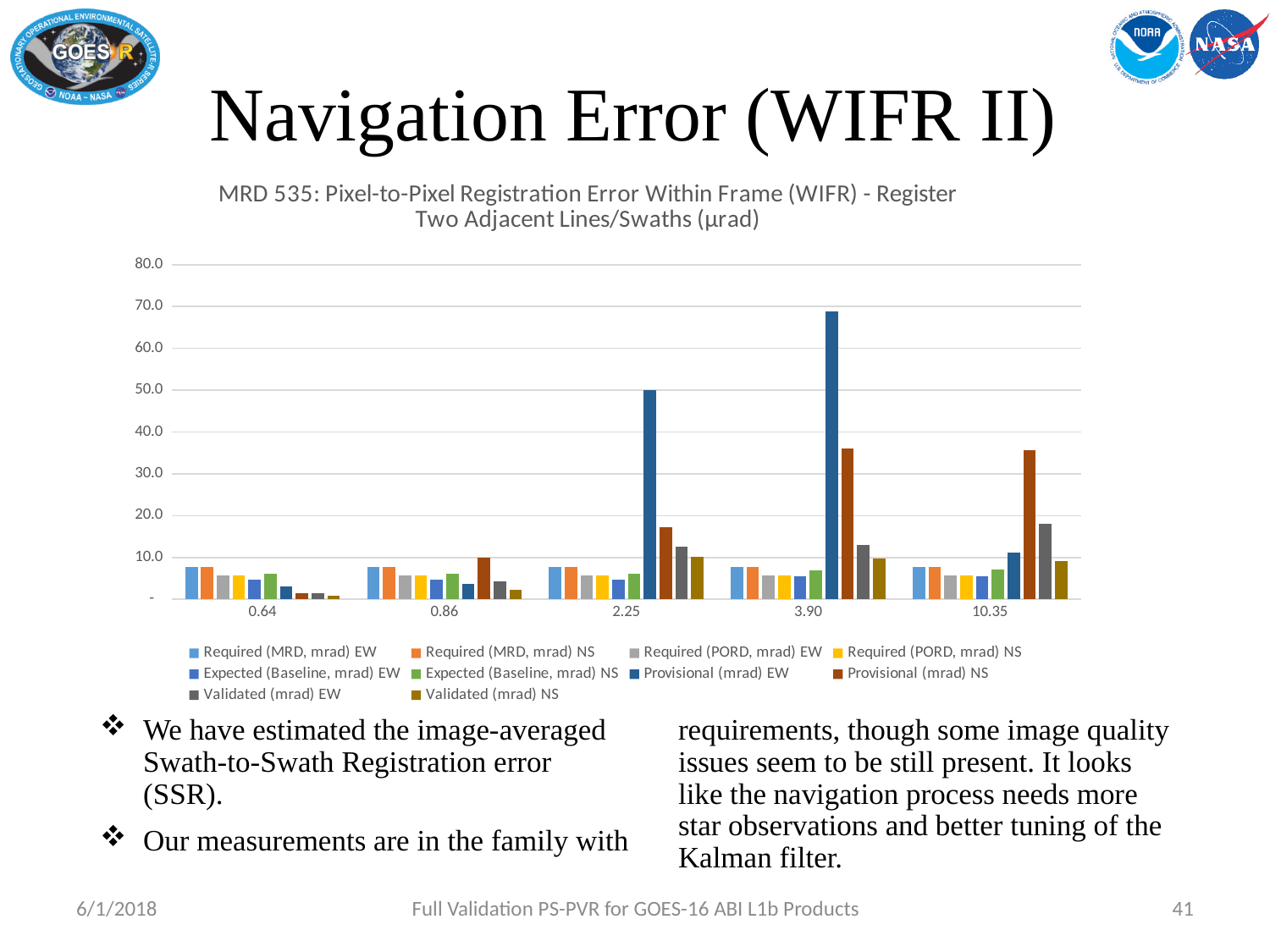
How many categories are shown along the x axis of the chart? 5 Is the value for Provisional (mrad) EW at 3.90 greater or less than 60? greater Is the value for Provisional (mrad) NS at 10.35 greater or less than 30? greater Which category contains the tallest bar in the chart? 3.90 Which series has the tallest bar in the 3.90 category? Provisional (mrad) EW Which is larger: Provisional (mrad) EW at 3.90 or Provisional (mrad) EW at 10.35? Provisional (mrad) EW at 3.90 How many series does the chart's legend list? 10 What is the highest value shown on the chart's y axis? 80.0 What kind of chart is shown on the slide? Bar chart Is the value for Required (MRD, mrad) EW at 0.64 greater or less than 10? less Which is larger: Provisional (mrad) NS at 3.90 or Provisional (mrad) NS at 2.25? Provisional (mrad) NS at 3.90